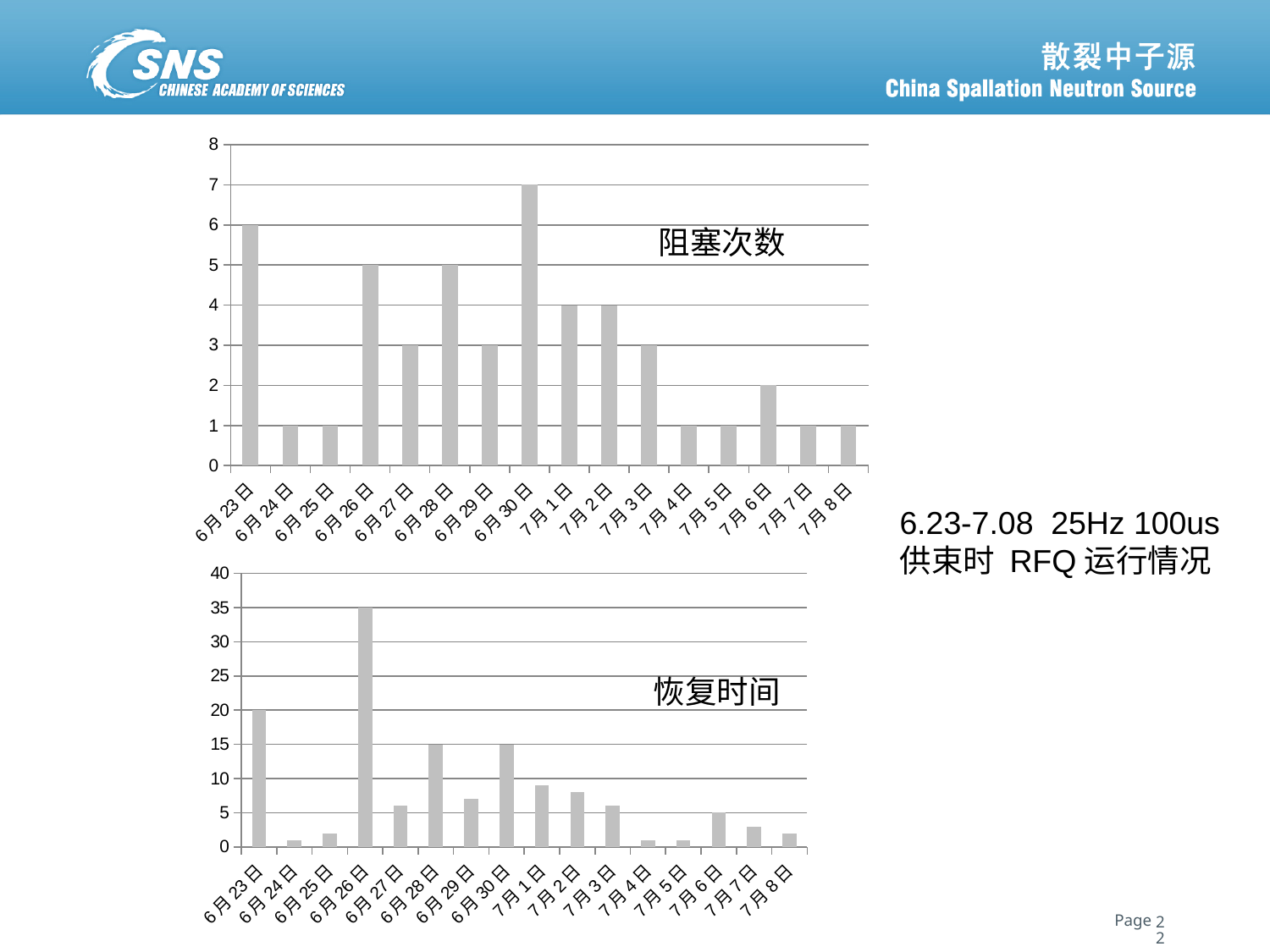
In the bottom chart (恢复时间), which date has the highest value? 6月26日 In the top chart (阻塞次数), what is the value for 6月30日? 7 In the bottom chart (恢复时间), what is the value for 6月23日? 20 In the top chart (阻塞次数), which date has the highest value? 6月30日 In the bottom chart (恢复时间), what is the value for 6月26日? 35 In the top chart (阻塞次数), how many dates are shown on the x axis? 16 What is the title shown on the bottom chart? 恢复时间 In the bottom chart (恢复时间), is the value for 7月1日 greater or less than 10? less What kind of chart is the top chart titled 阻塞次数? bar chart In the top chart (阻塞次数), what is the value for 6月23日? 6 In the top chart (阻塞次数), what is the difference between the values for 6月30日 and 6月23日? 1 In the top chart (阻塞次数), which is larger, the value for 6月26日 or the value for 6月27日? 6月26日